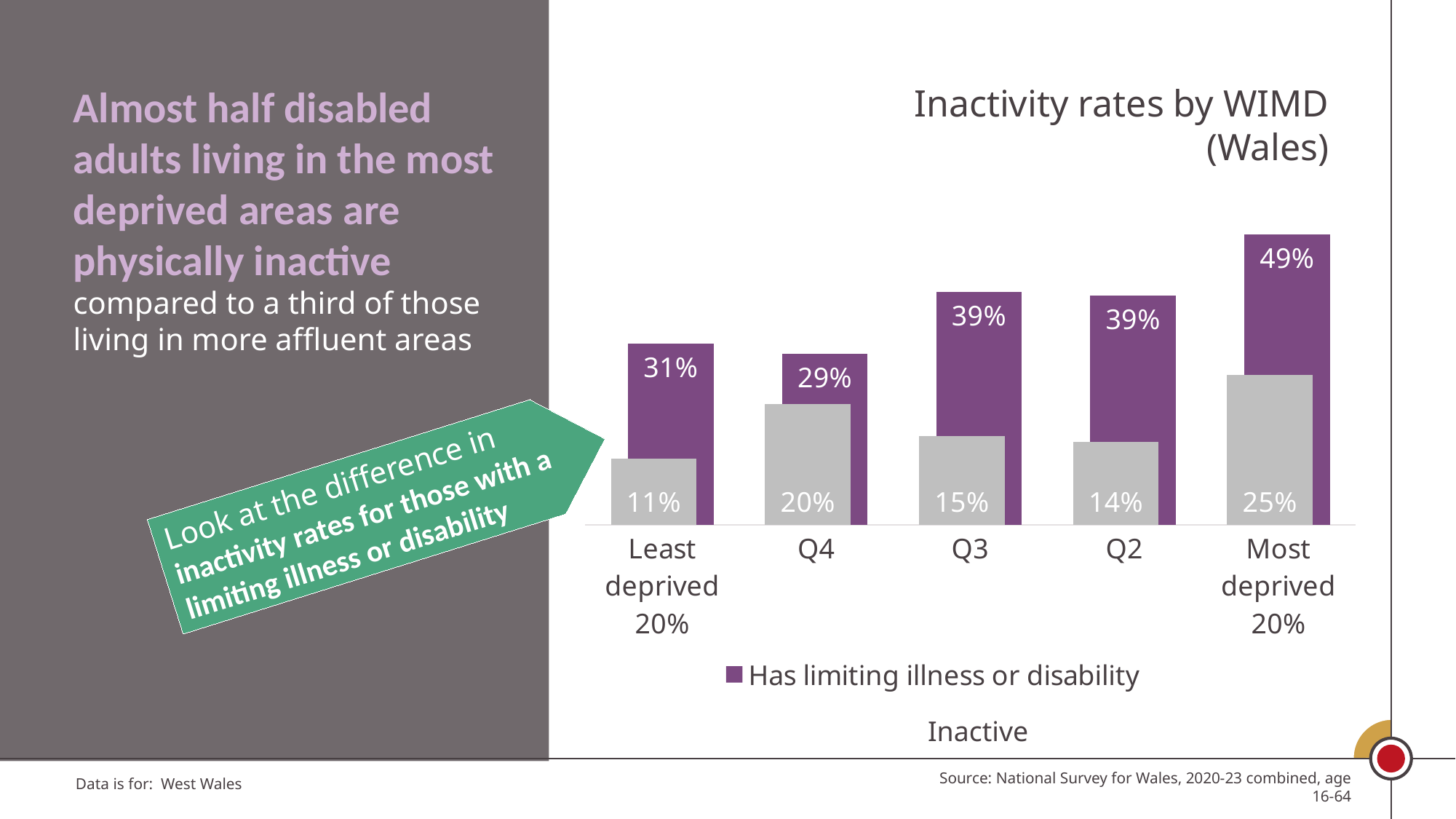
What is the inactivity rate for those with a limiting illness or disability in the Most deprived 20% group? 49% Which category has the highest value for 'Has limiting illness or disability'? Most deprived 20% What is the title of the chart? Inactivity rates by WIMD (Wales) What is the difference between the 'Has limiting illness or disability' values for the Most deprived 20% and Least deprived 20% groups? 18% What value does the grey bar show for Q4? 20% What is the difference between the 'Has limiting illness or disability' value and the grey bar value for the Most deprived 20% group? 24% Which is larger: the 'Has limiting illness or disability' value for Q3 or for Q4? Q3 What value does the grey bar show for the Least deprived 20% group? 11% What is the inactivity rate for those with a limiting illness or disability in the Least deprived 20% group? 31% Which category has the lowest value among the grey bars? Least deprived 20% What type of chart is shown on the slide? bar chart How many categories are shown on the x axis? 5